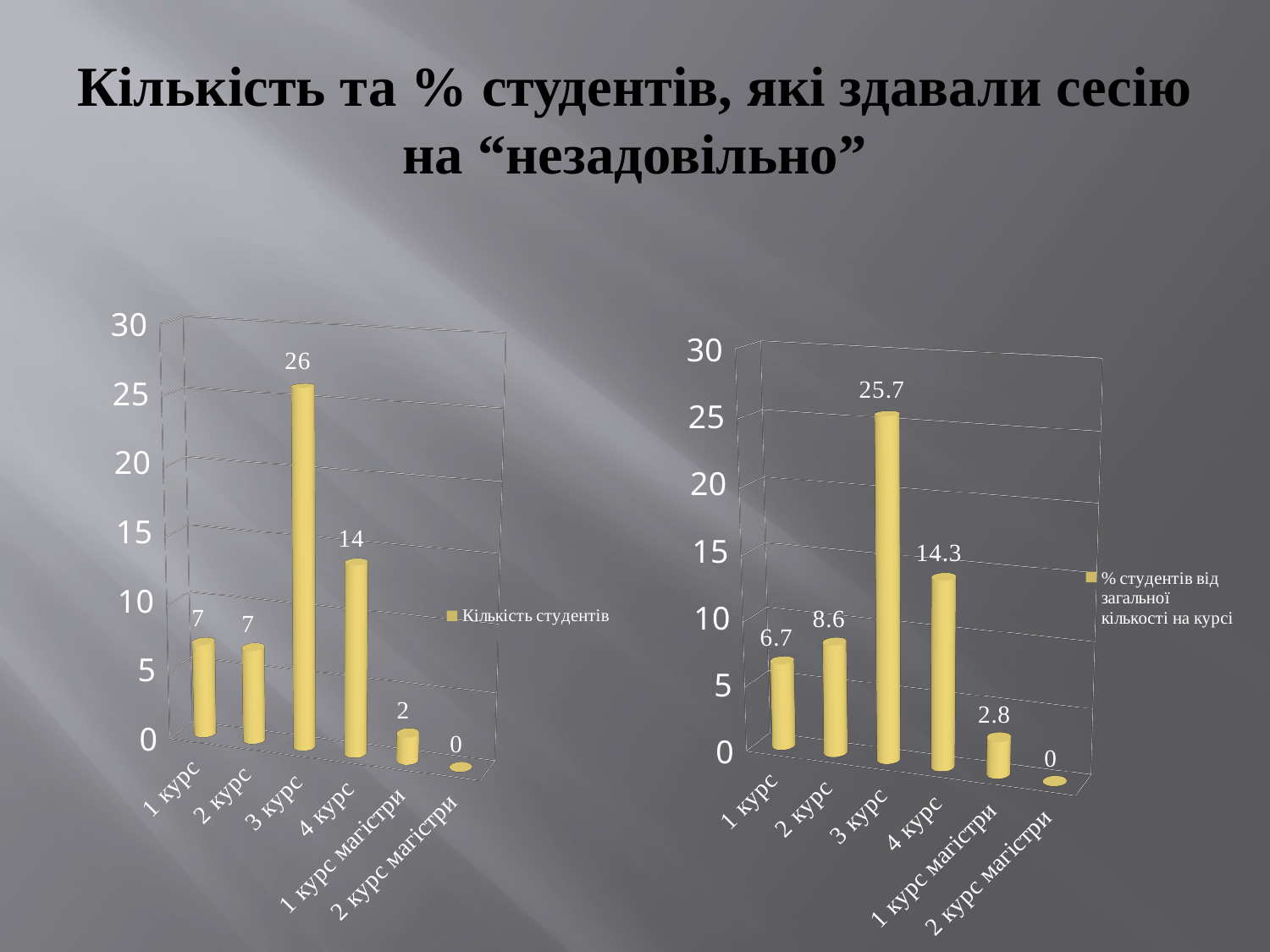
In the right chart (% студентів від загальної кількості на курсі), which is larger, the value for 1 курс or the value for 2 курс? 2 курс In the left chart (Кількість студентів), what is the value for 1 курс магістри? 2 In the left chart (Кількість студентів), which category has the highest value? 3 курс What is the legend entry of the left chart? Кількість студентів In the left chart (Кількість студентів), what is the difference between the values for 3 курс and 4 курс? 12 In the right chart (% студентів від загальної кількості на курсі), what is the value for 4 курс? 14.3 In the right chart (% студентів від загальної кількості на курсі), what is the difference between the values for 2 курс and 1 курс? 1.9 What kind of chart is the right chart (% студентів від загальної кількості на курсі)? bar chart In the right chart (% студентів від загальної кількості на курсі), which category has the lowest value? 2 курс магістри In the left chart (Кількість студентів), what is the value for 3 курс? 26 In the right chart (% студентів від загальної кількості на курсі), what is the value for 2 курс? 8.6 How many categories are shown on the x axis of the left chart (Кількість студентів)? 6